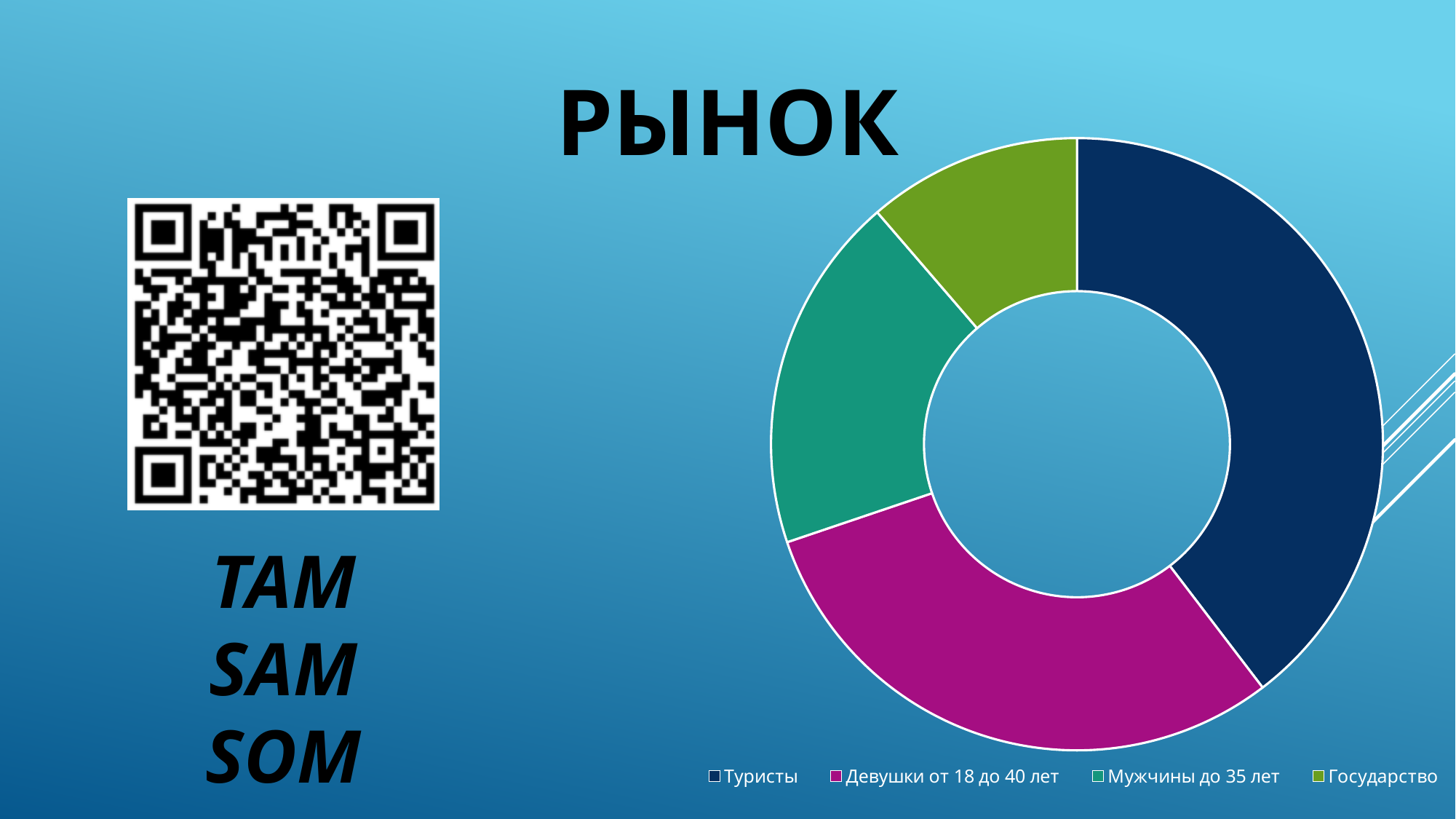
Which category is shown in magenta in the chart? Девушки от 18 до 40 лет What is the title of the slide above the chart? РЫНОК Which category has the largest share of the chart? Туристы How many categories does the chart show? 4 Which is larger: the share for Туристы or the share for Девушки от 18 до 40 лет? Туристы Which is larger: the share for Девушки от 18 до 40 лет or the share for Мужчины до 35 лет? Девушки от 18 до 40 лет Which is larger: the share for Туристы or the share for Государство? Туристы Which category has the smallest share of the chart? Государство What kind of chart is shown on the slide? Doughnut chart